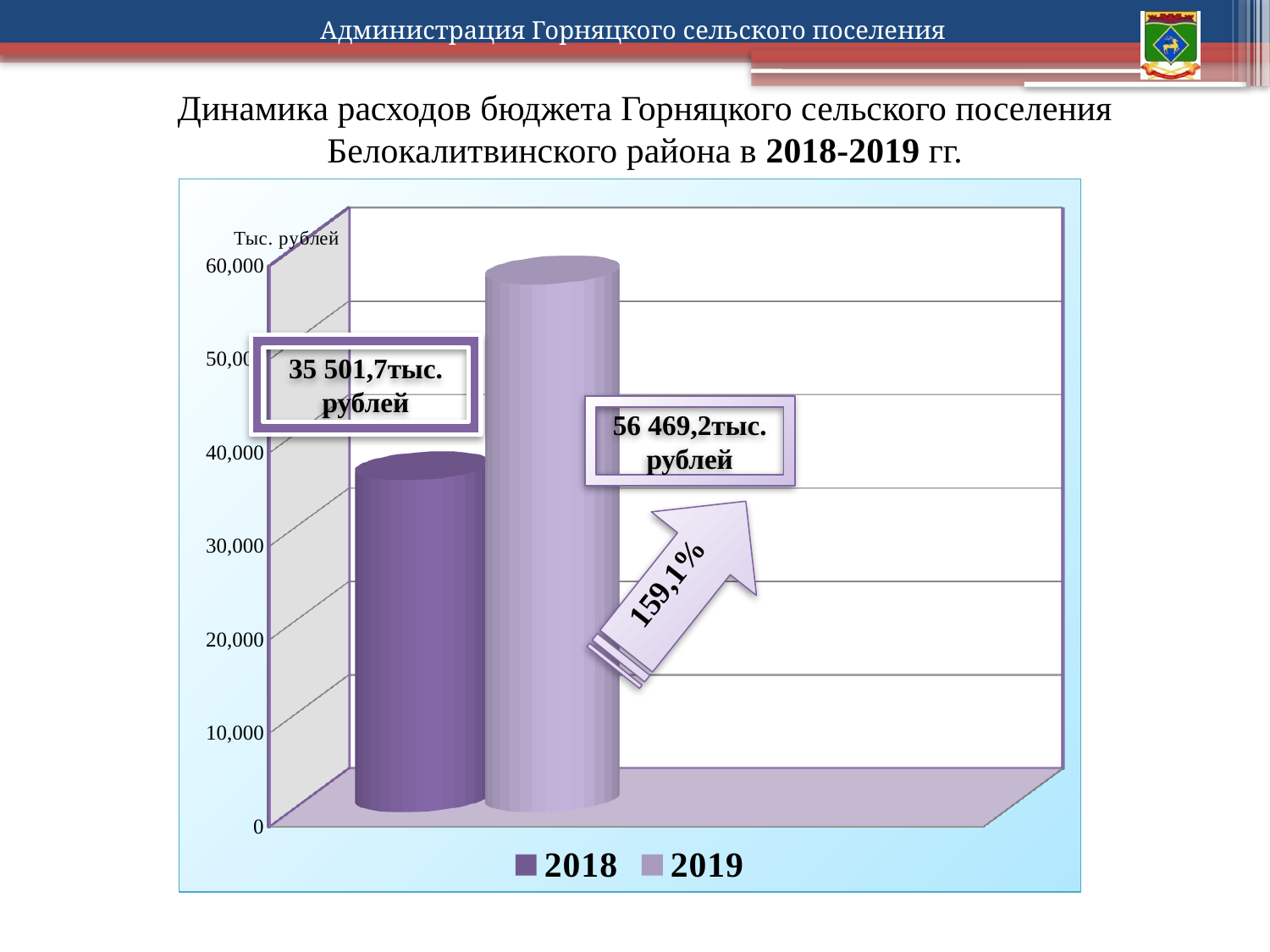
How many series does the legend list? 2 Do budget expenditures rise or fall from 2018 to 2019? Rise What percentage is written on the arrow between the bars? 159,1% How many bars are plotted on the chart? 2 Which year shows the lowest budget expenditure? 2018 Is the value for 2019 greater or less than 50,000? greater What is the budget expenditure value shown for 2018? 35 501,7 тыс. рублей Which year has the higher budget expenditure, 2018 or 2019? 2019 By how much does the 2019 expenditure exceed the 2018 expenditure? 20 967,5 тыс. рублей What kind of chart is shown on the slide? Bar chart Is the value for 2018 greater or less than 40,000? less What is the budget expenditure value shown for 2019? 56 469,2 тыс. рублей